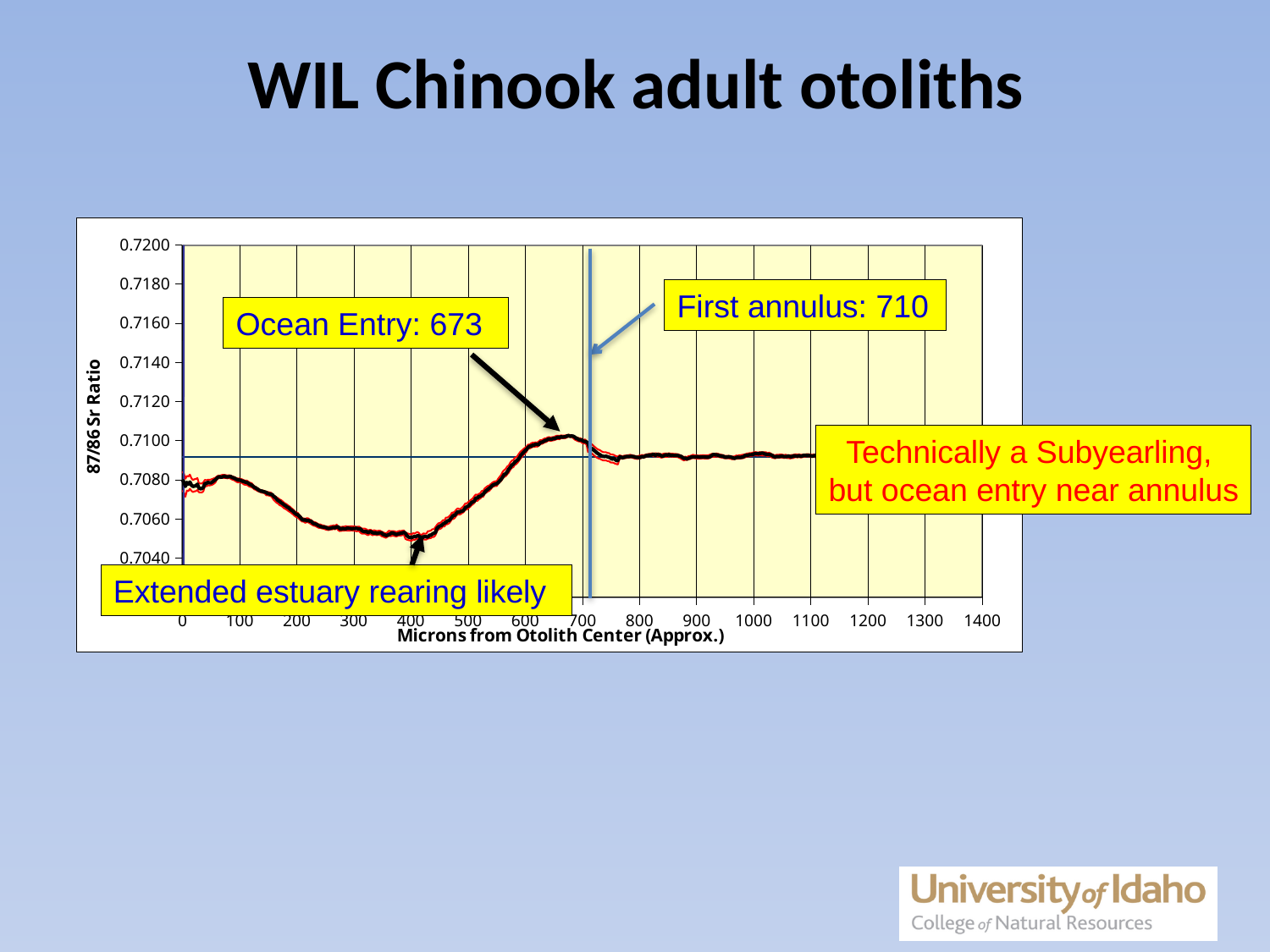
Is the 87/86 Sr Ratio at 400 microns from the otolith center greater or less than 0.7080? less What is the label on the vertical axis of the chart? 87/86 Sr Ratio Does the 87/86 Sr Ratio rise or fall between 100 and 300 microns from the otolith center? fall What kind of chart is shown on the slide? line chart What is the label on the horizontal axis of the chart? Microns from Otolith Center (Approx.) According to the annotation on the chart, at how many microns does ocean entry occur? 673 How many microns separate the first annulus (710) from ocean entry (673) on the chart? 37 Does the 87/86 Sr Ratio rise or fall between 400 and 650 microns from the otolith center? rise According to the annotation on the chart, at how many microns is the first annulus? 710 Which is larger, the 87/86 Sr Ratio at 650 microns or at 400 microns? 650 microns Is the 87/86 Sr Ratio at 650 microns from the otolith center greater or less than 0.7080? greater Is the 87/86 Sr Ratio at 1000 microns from the otolith center greater or less than 0.7080? greater